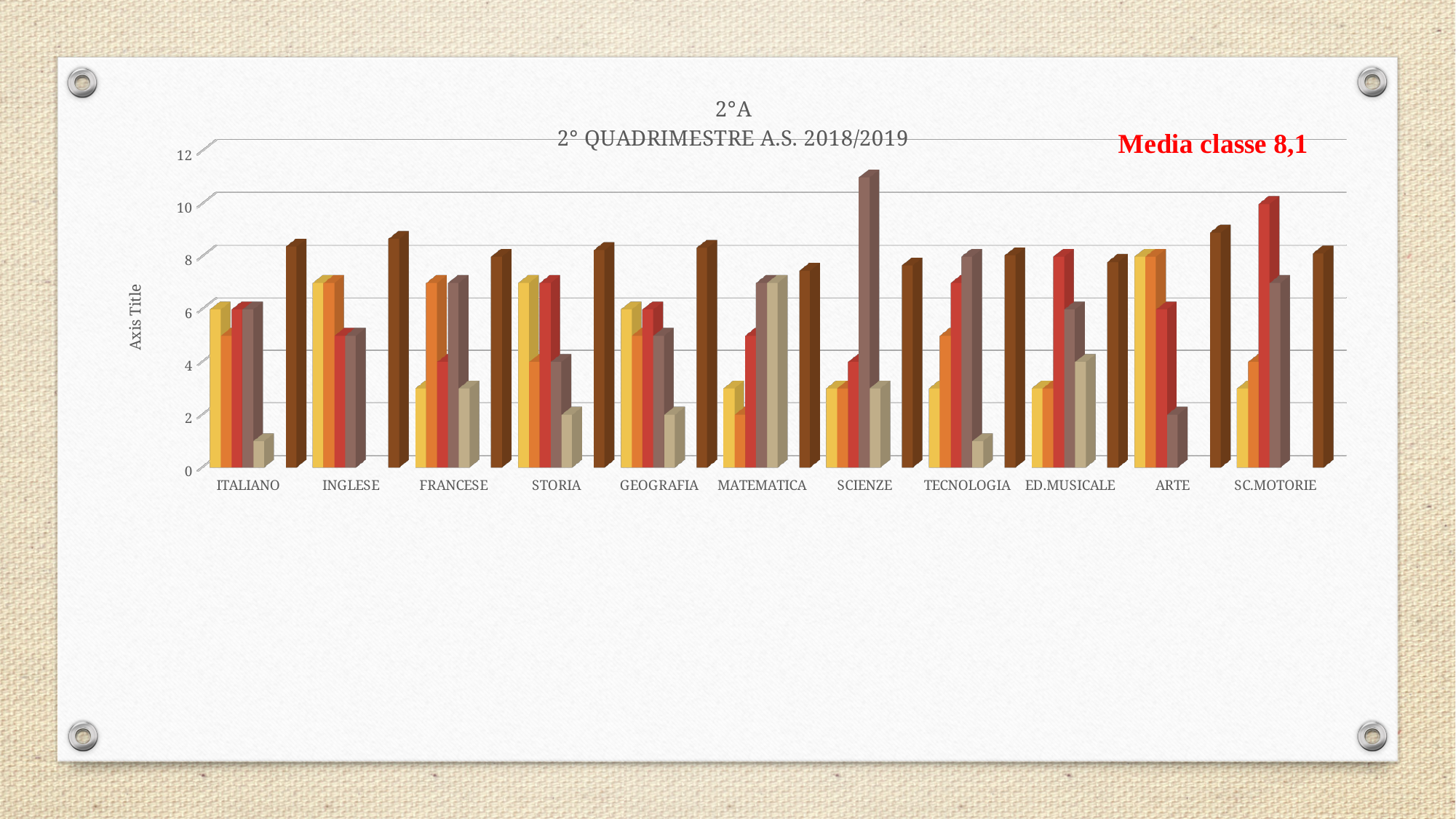
Is the tan bar for ED.MUSICALE greater or less than 2? greater Is the yellow bar for ARTE greater or less than 6? greater Is the yellow bar for FRANCESE greater or less than 4? less Which category contains the tallest bar in the chart? SCIENZE What kind of chart is shown on the slide? bar chart What class average is written in red text on the slide? Media classe 8,1 How many subject categories are shown on the x axis of the chart? 11 What is the title of the chart? 2°A 2° QUADRIMESTRE A.S. 2018/2019